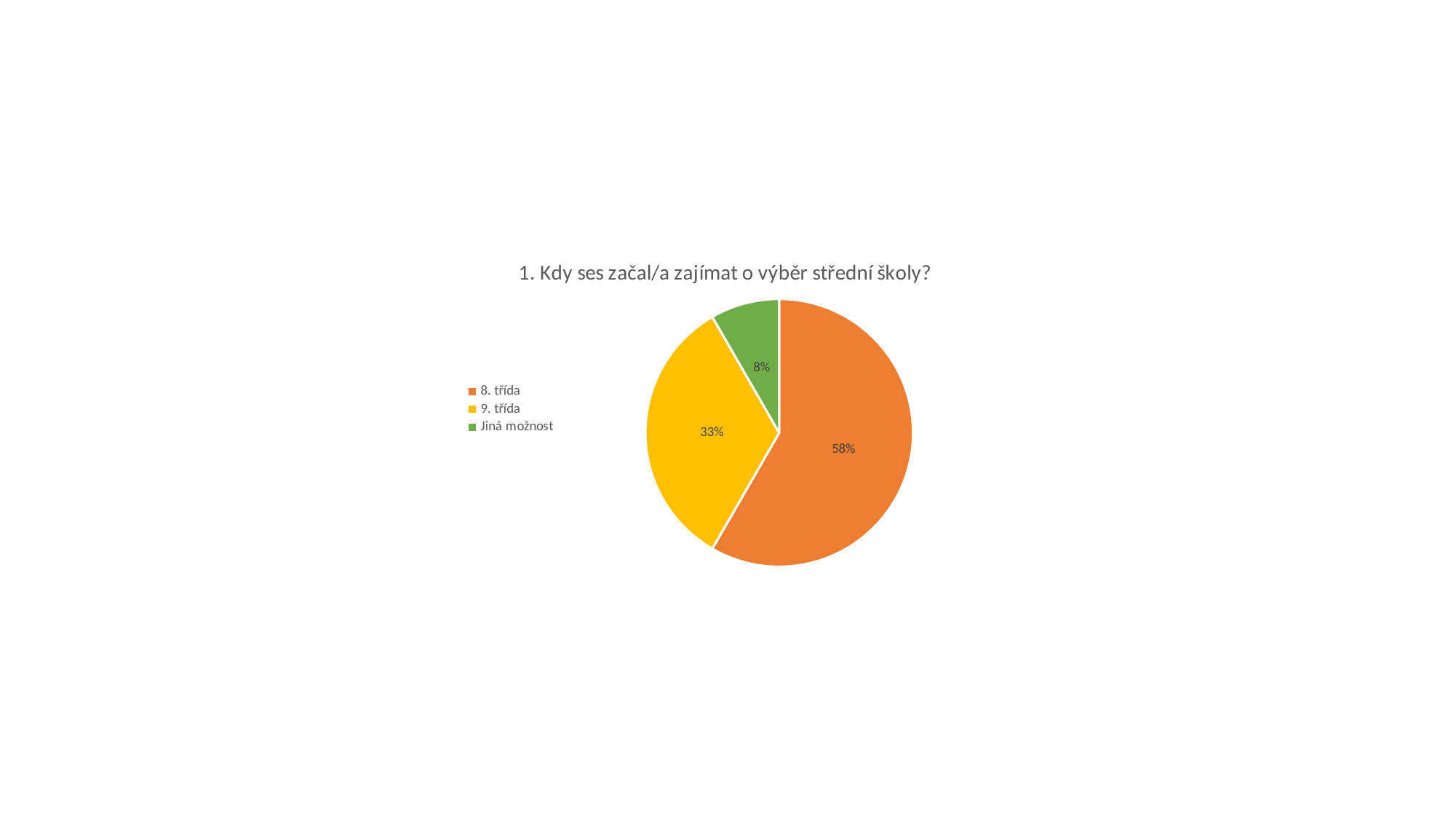
What is the difference in percentage points between the "9. třída" and "Jiná možnost" slices? 25 What share of the pie does "9. třída" have? 33% Which category has the smallest slice of the pie? Jiná možnost Which category has the largest slice of the pie? 8. třída What is the difference in percentage points between the "8. třída" and "9. třída" slices? 25 How many categories does the pie chart show? 3 What share of the pie does "Jiná možnost" have? 8% What colour is the slice for "Jiná možnost"? Green Which is larger, the slice for "9. třída" or the slice for "Jiná možnost"? 9. třída What is the title of the chart? 1. Kdy ses začal/a zajímat o výběr střední školy? What kind of chart is shown on the slide? Pie chart What share of the pie does "8. třída" have? 58%